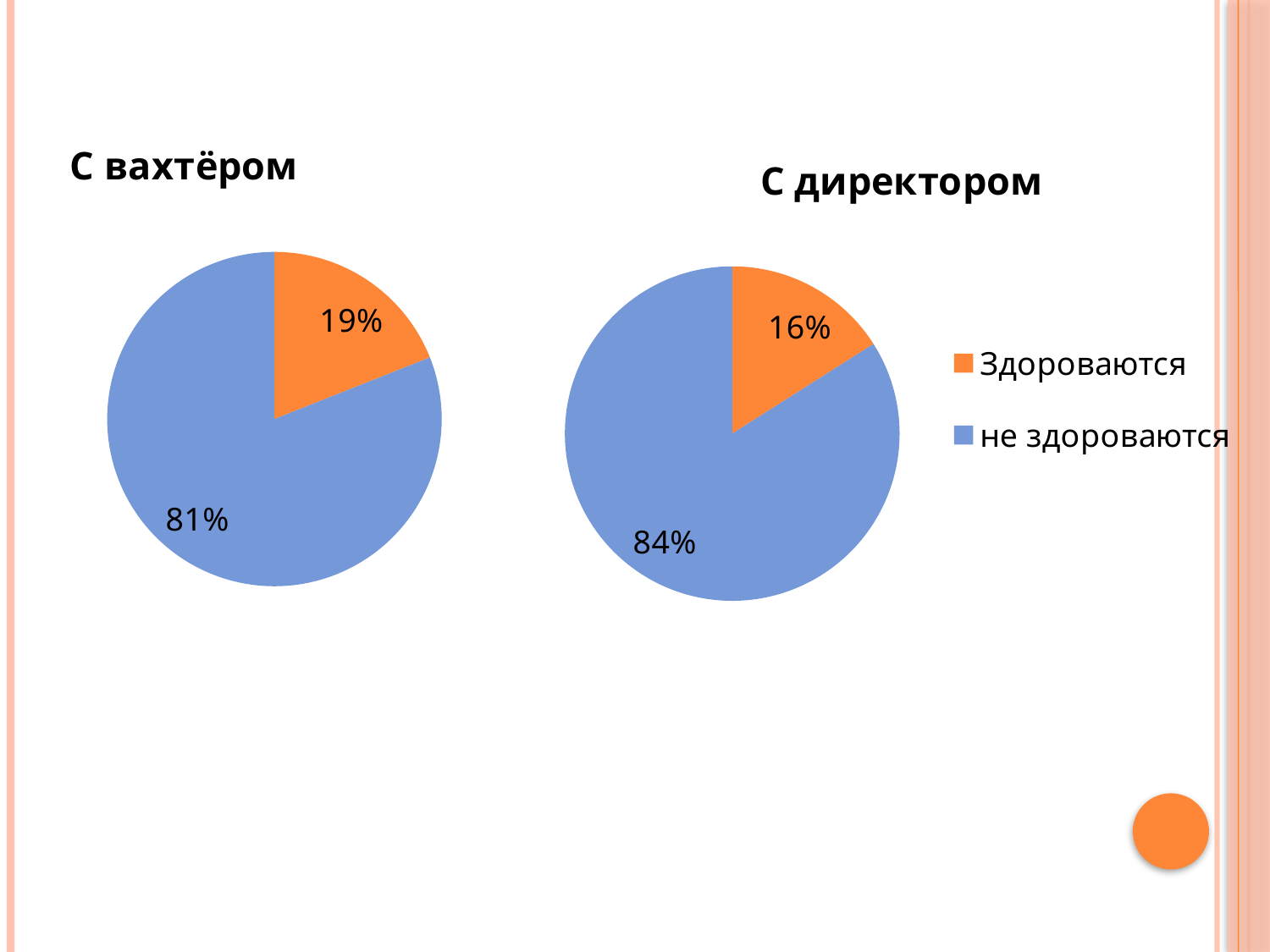
What kind of chart is the chart titled "С вахтёром"? Pie chart How many slices does the chart titled "С директором" have? 2 In the chart titled "С директором", which category has the smallest slice? Здороваются In the chart titled "С вахтёром", which category has the largest slice? не здороваются Which is larger: the "Здороваются" share in the chart titled "С вахтёром" or in the chart titled "С директором"? С вахтёром In the chart titled "С вахтёром", what share of the pie is "Здороваются"? 19% What is the difference between the "не здороваются" and "Здороваются" shares in the chart titled "С вахтёром"? 62% In the chart titled "С директором", what share of the pie is "Здороваются"? 16% In the chart titled "С директором", what share of the pie is "не здороваются"? 84% What colour represents "Здороваются" in the pie charts? Orange How many entries does the legend on the slide list? 2